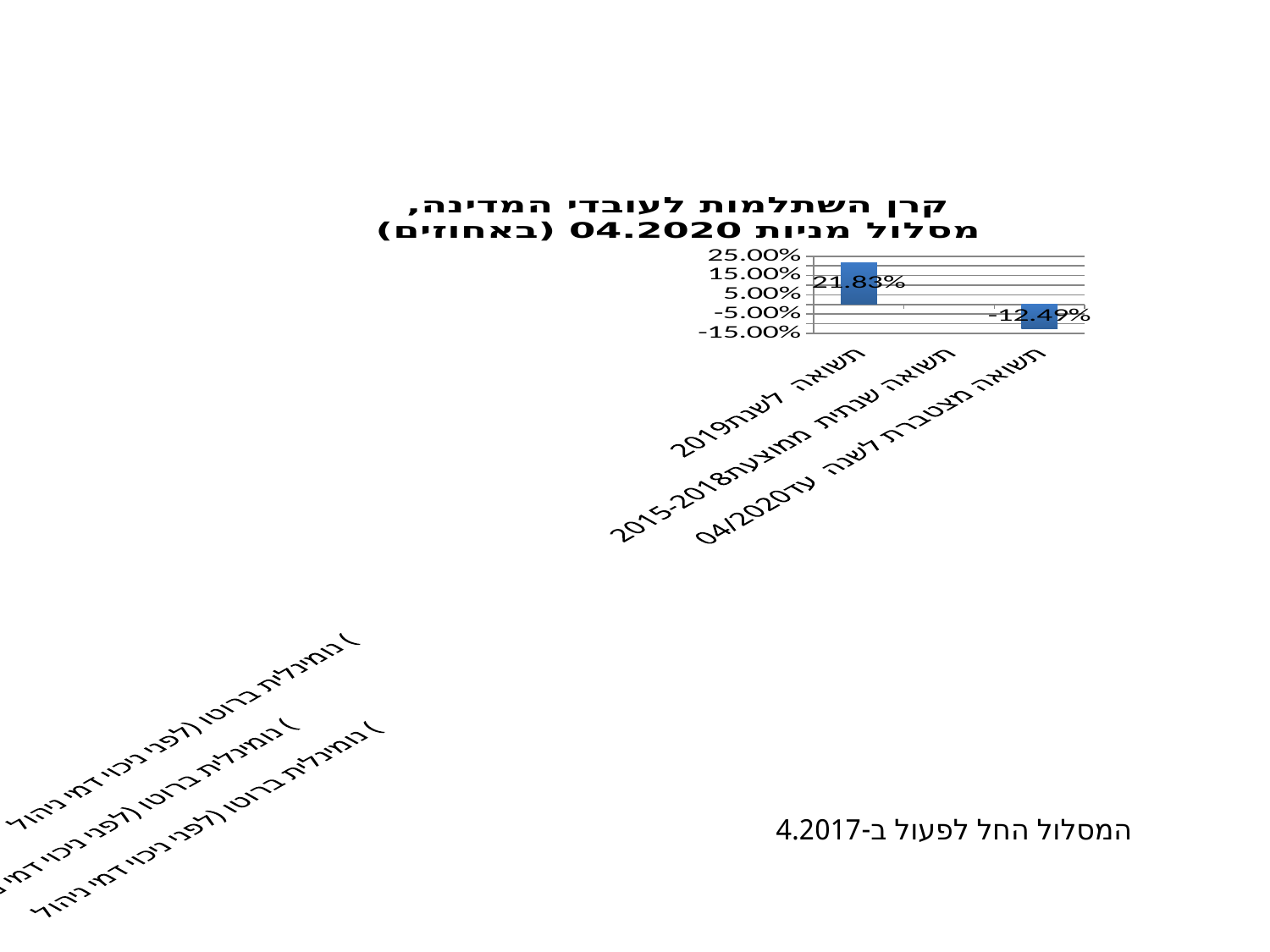
What is the value for תשואה מצטברת לשנה עד 04/2020? -12.49% Which category has the lowest plotted value? תשואה מצטברת לשנה עד 04/2020 Which category on the x axis has no bar plotted? תשואה שנתית ממוצעת 2015-2018 Which is larger: the value for תשואה לשנת 2019 or the value for תשואה מצטברת לשנה עד 04/2020? תשואה לשנת 2019 Is the value for תשואה מצטברת לשנה עד 04/2020 greater or less than -5.00%? less What is the highest value shown on the y axis? 25.00% Which category has the highest value? תשואה לשנת 2019 What is the difference between the value for תשואה לשנת 2019 and the value for תשואה מצטברת לשנה עד 04/2020? 34.32% What kind of chart is shown on the slide? bar chart What is the value for תשואה לשנת 2019? 21.83% How many categories are shown on the x axis? 3 Is the value for תשואה לשנת 2019 greater or less than 15.00%? greater